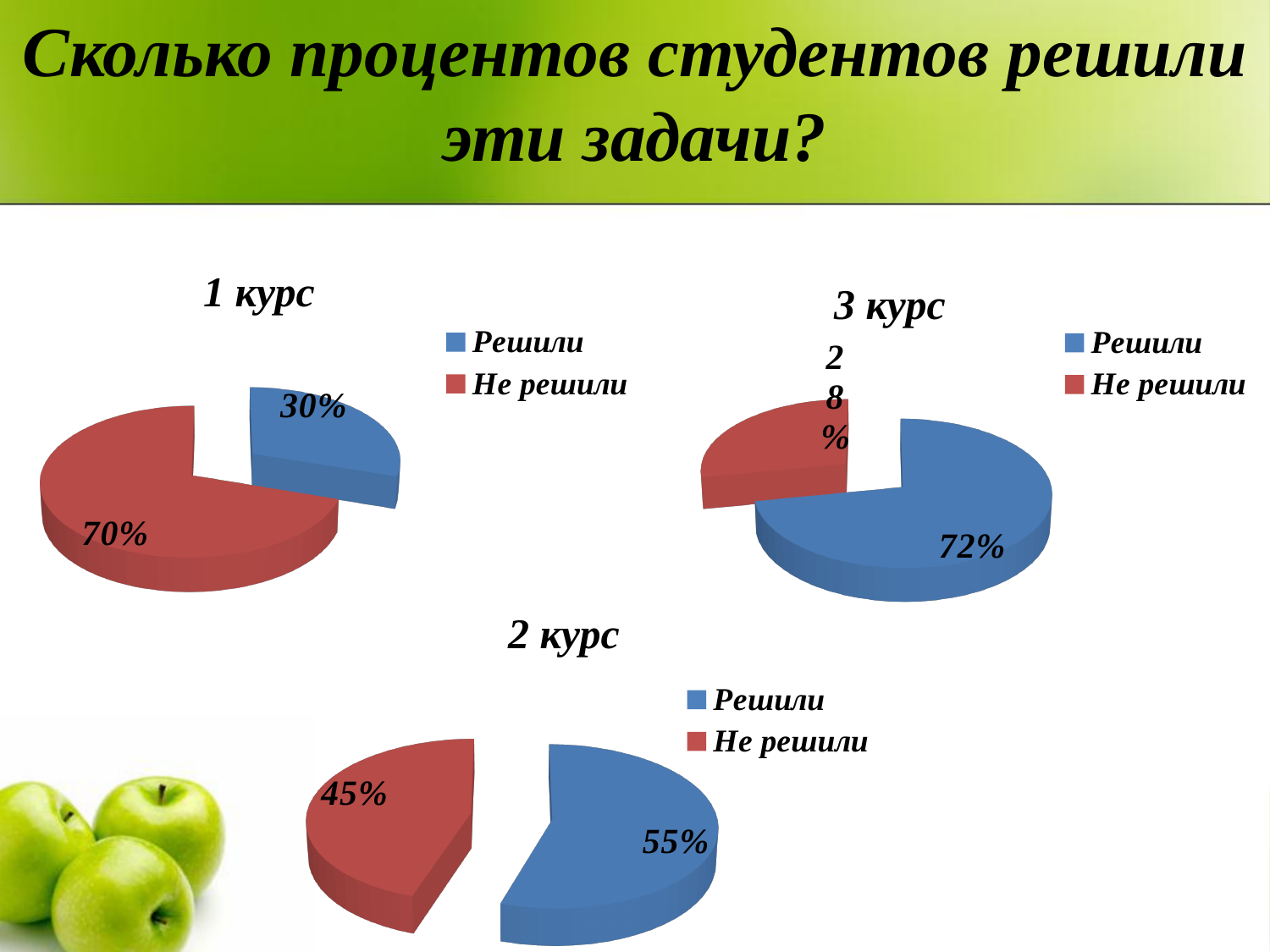
In the "3 курс" chart, which slice is the largest? Решили In the "1 курс" chart, what percentage is shown for "Не решили"? 70% What type of chart is the "2 курс" chart? Pie chart In the "1 курс" chart, what colour is the "Решили" slice? Blue In the "2 курс" chart, what percentage is shown for "Не решили"? 45% In the "2 курс" chart, what percentage is shown for "Решили"? 55% In the "3 курс" chart, what percentage is shown for "Не решили"? 28% In the "1 курс" chart, which slice is larger, "Решили" or "Не решили"? Не решили In the "2 курс" chart, what is the difference between the "Решили" and "Не решили" percentages? 10% In the "3 курс" chart, what percentage is shown for "Решили"? 72% How many entries does the legend of the "3 курс" chart list? 2 In the "1 курс" chart, what percentage of students is shown for "Решили"? 30%